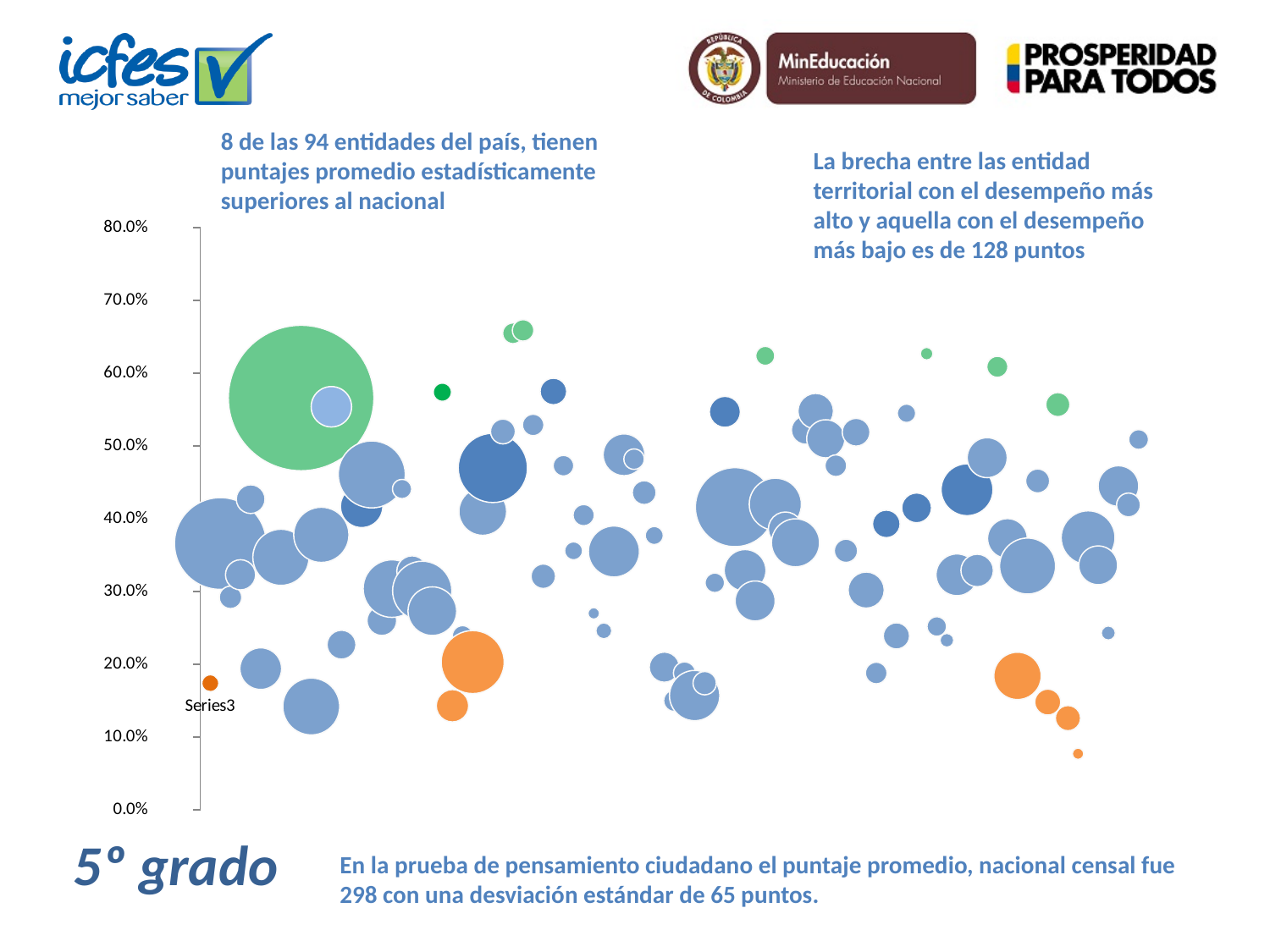
Is the value for the point labelled Series3 greater or less than 10%? greater What is the highest value shown on the chart's vertical axis? 80.0% What kind of chart is shown on the slide? bubble chart Is the value for the point labelled Series3 greater or less than 20%? less What colours are used for the bubbles in the chart? blue, green and orange